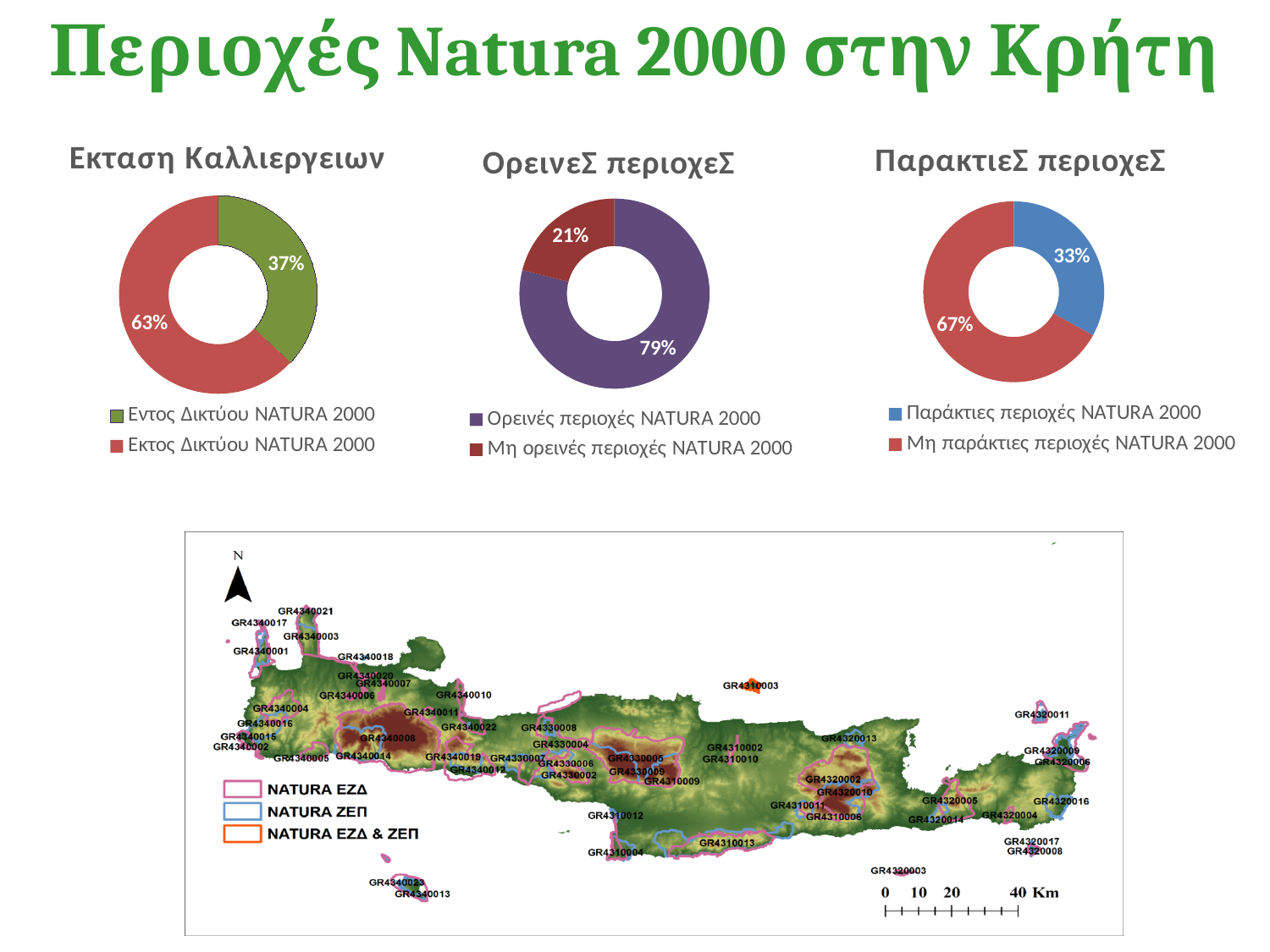
In the 'ΟρεινεΣ περιοχεΣ' chart, which slice is the largest? Ορεινές περιοχές NATURA 2000 In the 'ΟρεινεΣ περιοχεΣ' chart, which is larger: 'Ορεινές περιοχές NATURA 2000' or 'Μη ορεινές περιοχές NATURA 2000'? Ορεινές περιοχές NATURA 2000 In the 'ΠαρακτιεΣ περιοχεΣ' chart, what share is labelled 'Παράκτιες περιοχές NATURA 2000'? 33% What kind of chart is the 'Εκταση Καλλιεργειων' chart? Pie (donut) chart In the 'Εκταση Καλλιεργειων' chart, what share is labelled 'Εντος Δικτύου NATURA 2000'? 37% In the 'ΠαρακτιεΣ περιοχεΣ' chart, which slice is the smallest? Παράκτιες περιοχές NATURA 2000 In the 'ΟρεινεΣ περιοχεΣ' chart, what share is labelled 'Ορεινές περιοχές NATURA 2000'? 79% How many slices does the 'ΠαρακτιεΣ περιοχεΣ' chart have? 2 In the 'Εκταση Καλλιεργειων' chart, what is the difference in percentage points between the 'Εκτος Δικτύου NATURA 2000' and 'Εντος Δικτύου NATURA 2000' slices? 26 percentage points